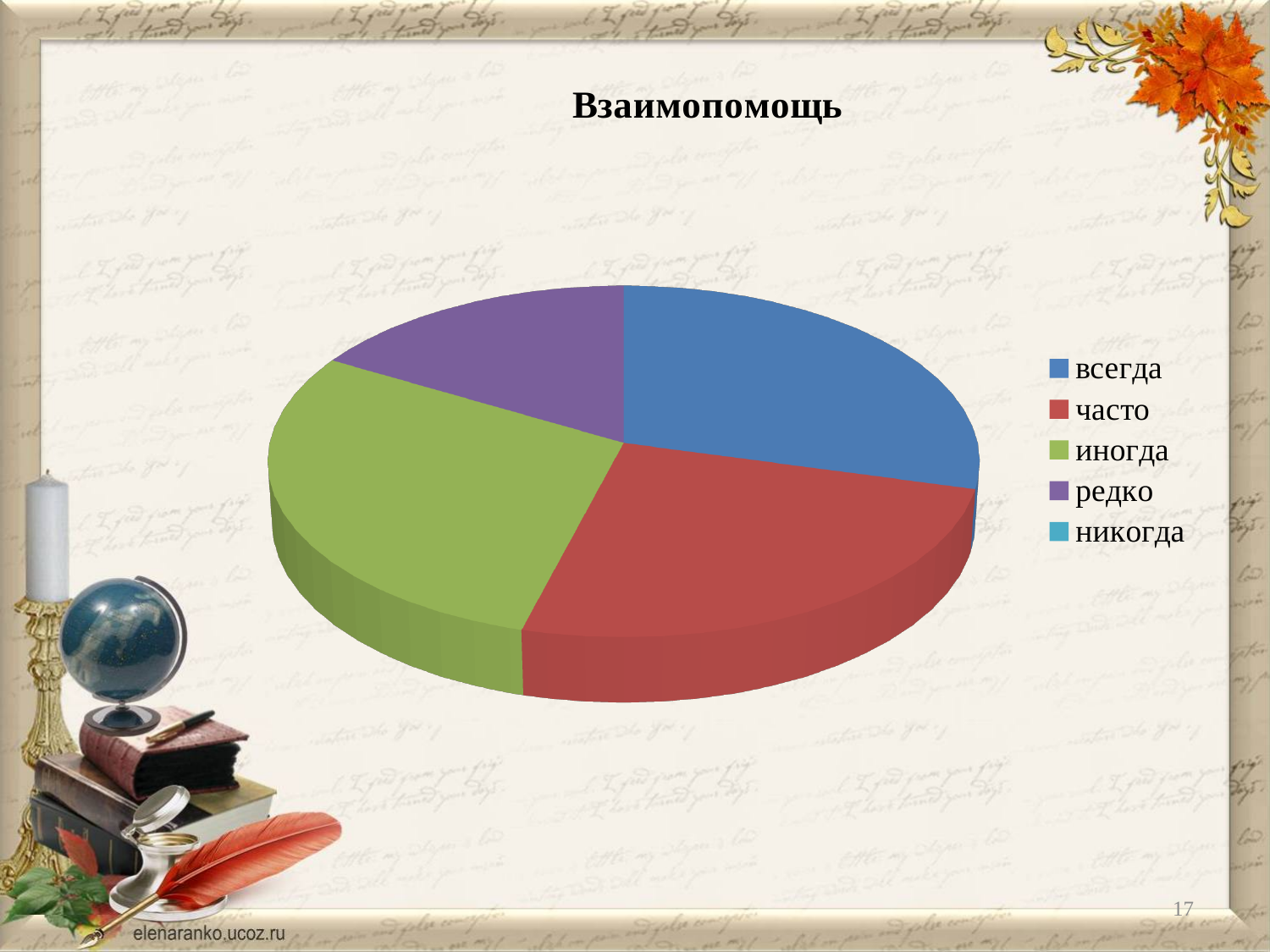
Which is larger in the pie chart, the slice for "иногда" or the slice for "редко"? иногда How many categories does the chart's legend list? 5 Which is larger in the pie chart, the slice for "часто" or the slice for "редко"? часто Which is larger in the pie chart, the slice for "всегда" or the slice for "редко"? всегда Which colour represents the category "иногда" in the chart? green What is the title of the chart? Взаимопомощь What kind of chart is shown on the slide? pie chart